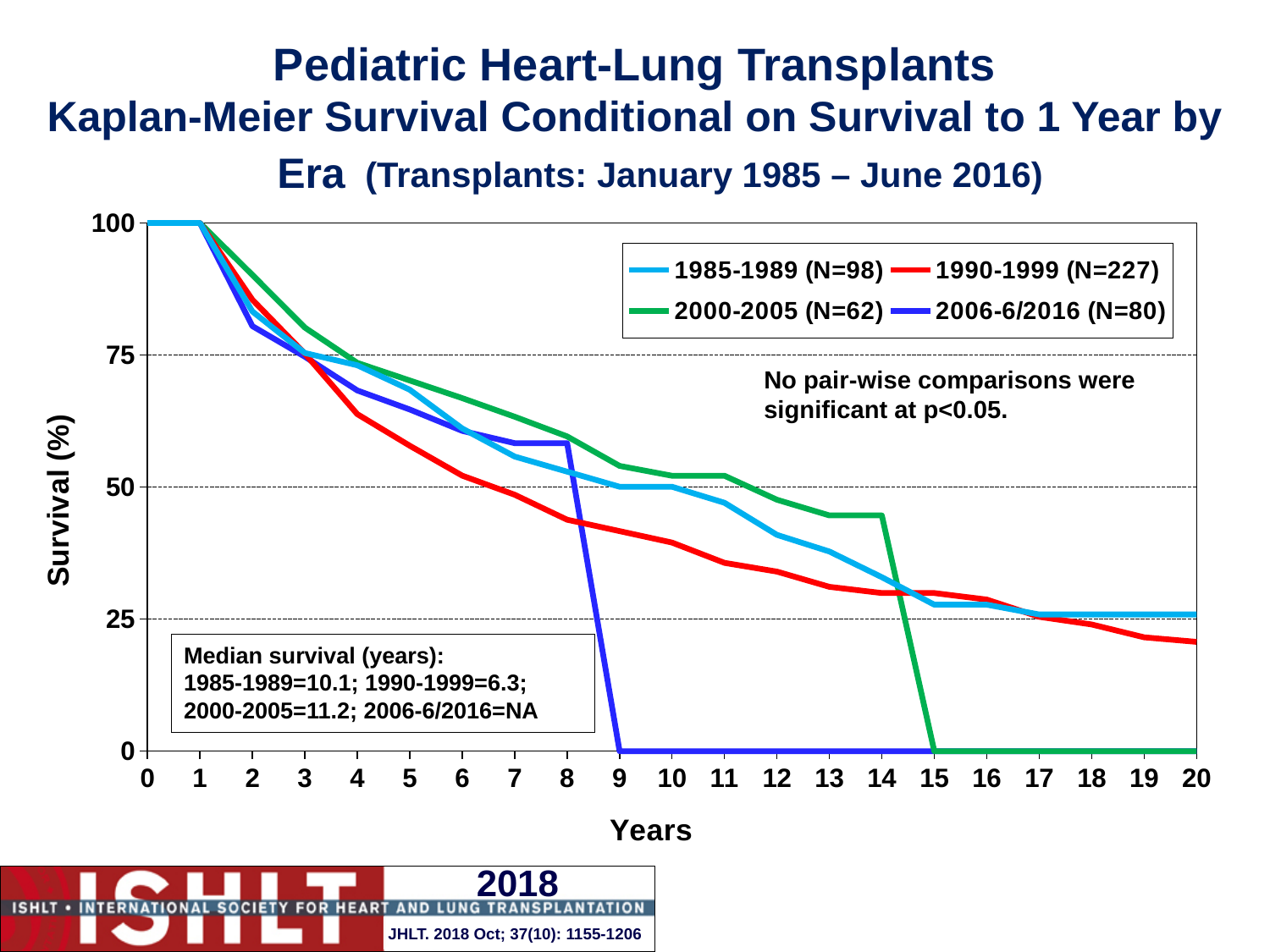
What is the N for the 1990-1999 era shown in the legend? 227 Which era has the lowest median survival among those with a value given? 1990-1999 What is the median survival in years for the 2000-2005 era? 11.2 How many series does the legend list? 4 Which era has the highest median survival among those with a value given? 2000-2005 What kind of chart is shown on the slide? line chart At year 13, which era has the higher survival: 2000-2005 or 1990-1999? 2000-2005 What is the N for the 2006-6/2016 era shown in the legend? 80 Is the survival for the 1990-1999 era at year 20 greater or less than 25? less Do the survival curves rise or fall as years increase? fall Is the survival for the 2006-6/2016 era at year 8 greater or less than 50? greater What is the median survival in years for the 1985-1989 era? 10.1